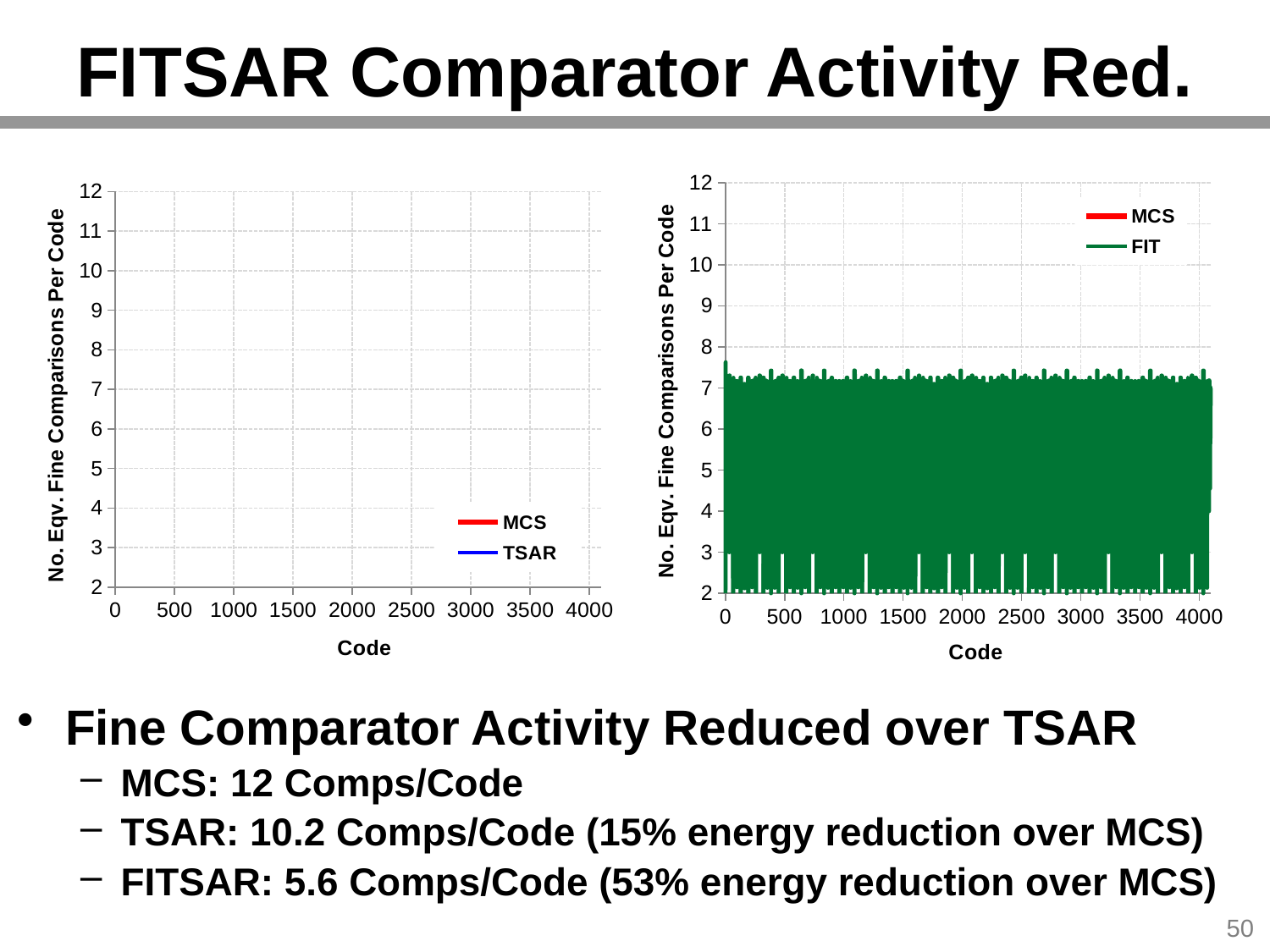
What is the x-axis title of the left chart? Code In the right chart, is the lowest value of the FIT series greater or less than 3? less In the right chart, is the highest value of the FIT series greater or less than 7? greater How many series does the legend of the left chart list? 2 Which series is shown in green in the right chart? FIT In the right chart, is the highest value of the FIT series greater or less than 8? less What kind of chart is the right chart? Line chart How many series does the legend of the right chart list? 2